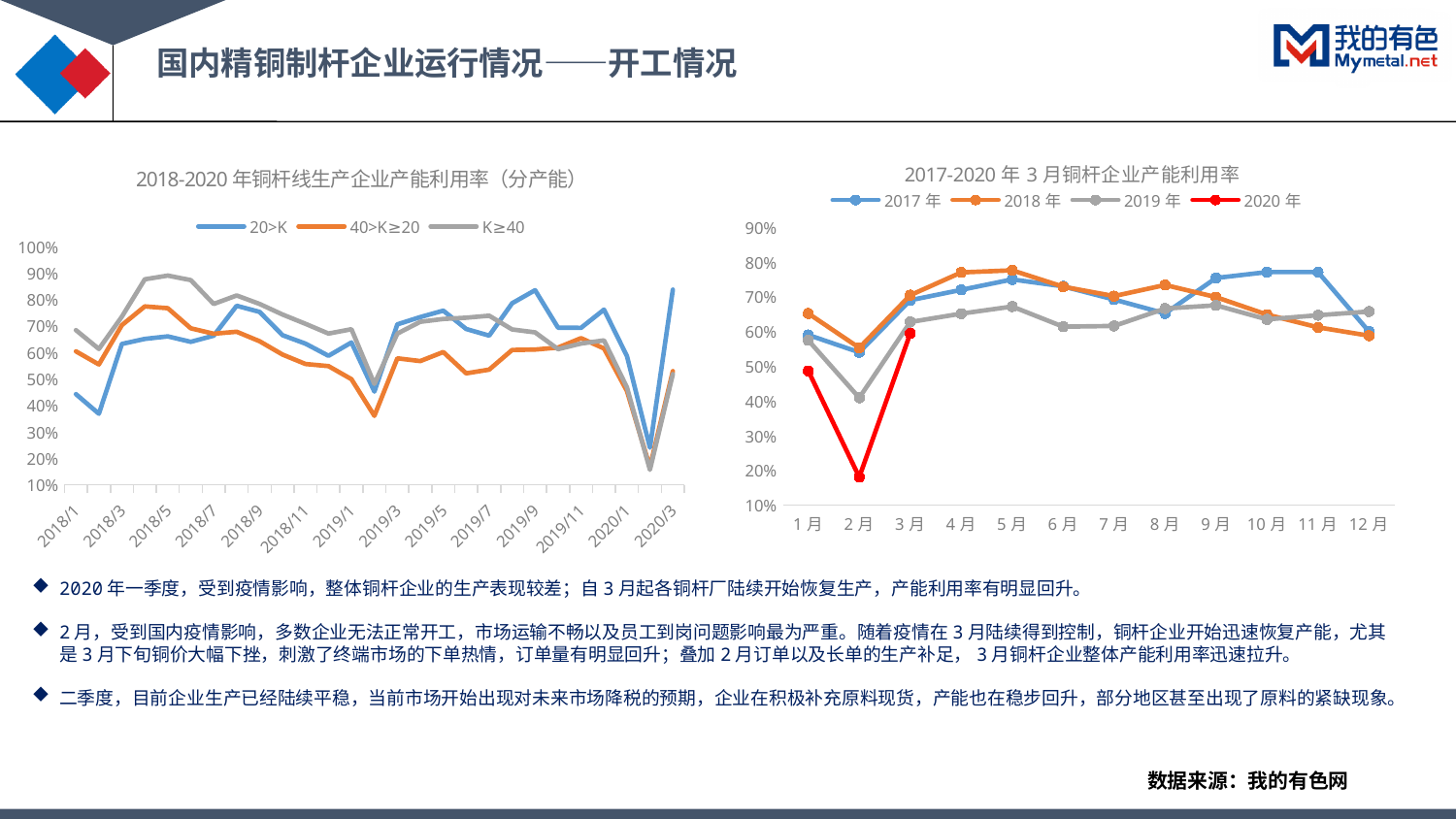
In the right-hand chart (2017-2020年3月铜杆企业产能利用率), which year has the lowest value in 2月? 2020年 How many series does the legend of the right-hand chart (2017-2020年3月铜杆企业产能利用率) list? 4 In the left-hand chart (2018-2020年铜杆线生产企业产能利用率（分产能）), which series has the highest value at 2020/3? 20>K In the right-hand chart (2017-2020年3月铜杆企业产能利用率), is the value for 2017年 in 10月 greater or less than 70%? greater In the right-hand chart (2017-2020年3月铜杆企业产能利用率), is the value for 2020年 in 2月 greater or less than 30%? less In the right-hand chart (2017-2020年3月铜杆企业产能利用率), which is larger in 2月: the value for 2018年 or for 2019年? 2018年 What kind of chart is the right-hand chart titled 2017-2020年3月铜杆企业产能利用率? Line chart How many months are shown on the x axis of the right-hand chart (2017-2020年3月铜杆企业产能利用率)? 12 In the left-hand chart (2018-2020年铜杆线生产企业产能利用率（分产能）), is the value for 40>K≥20 at 2020/2 greater or less than 30%? less In the right-hand chart (2017-2020年3月铜杆企业产能利用率), does the 2020年 line rise or fall from 2月 to 3月? Rise In the right-hand chart (2017-2020年3月铜杆企业产能利用率), what colour is the line for 2020年? Red How many series does the legend of the left-hand chart (2018-2020年铜杆线生产企业产能利用率（分产能）) list? 3